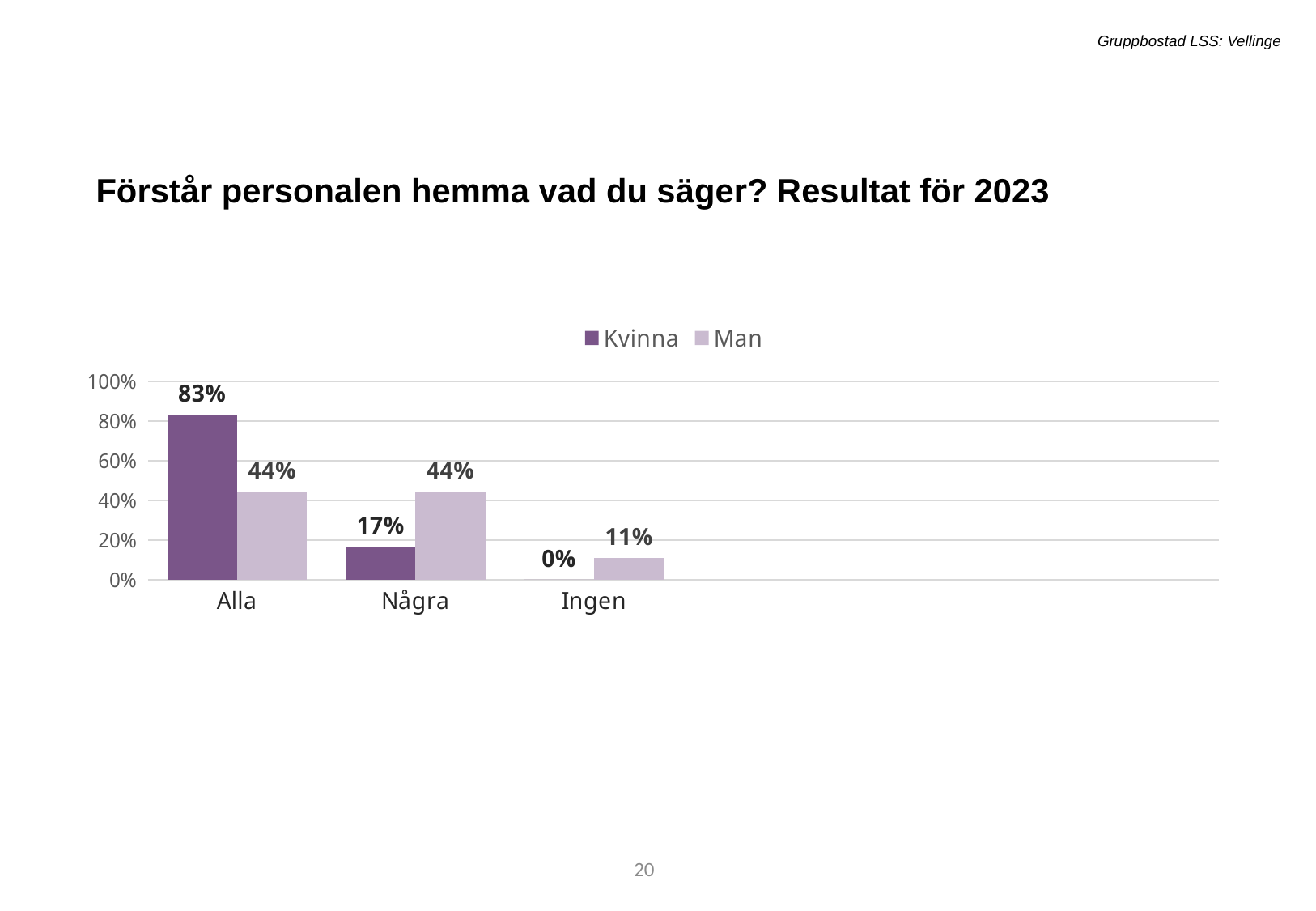
What is the value for Kvinna in the Ingen category? 0% What kind of chart is shown on the slide? Bar chart What is the difference between the Kvinna and Man values in the Alla category? 39 percentage points Which category has the highest value for Kvinna? Alla What is the value for Man in the Några category? 44% How many categories are shown on the x axis? 3 How many series does the legend list? 2 What is the value for Kvinna in the Alla category? 83% What is the value for Man in the Ingen category? 11% Which category has the lowest value for Man? Ingen What are the two series named in the legend? Kvinna and Man In the Några category, which series has the larger value, Kvinna or Man? Man